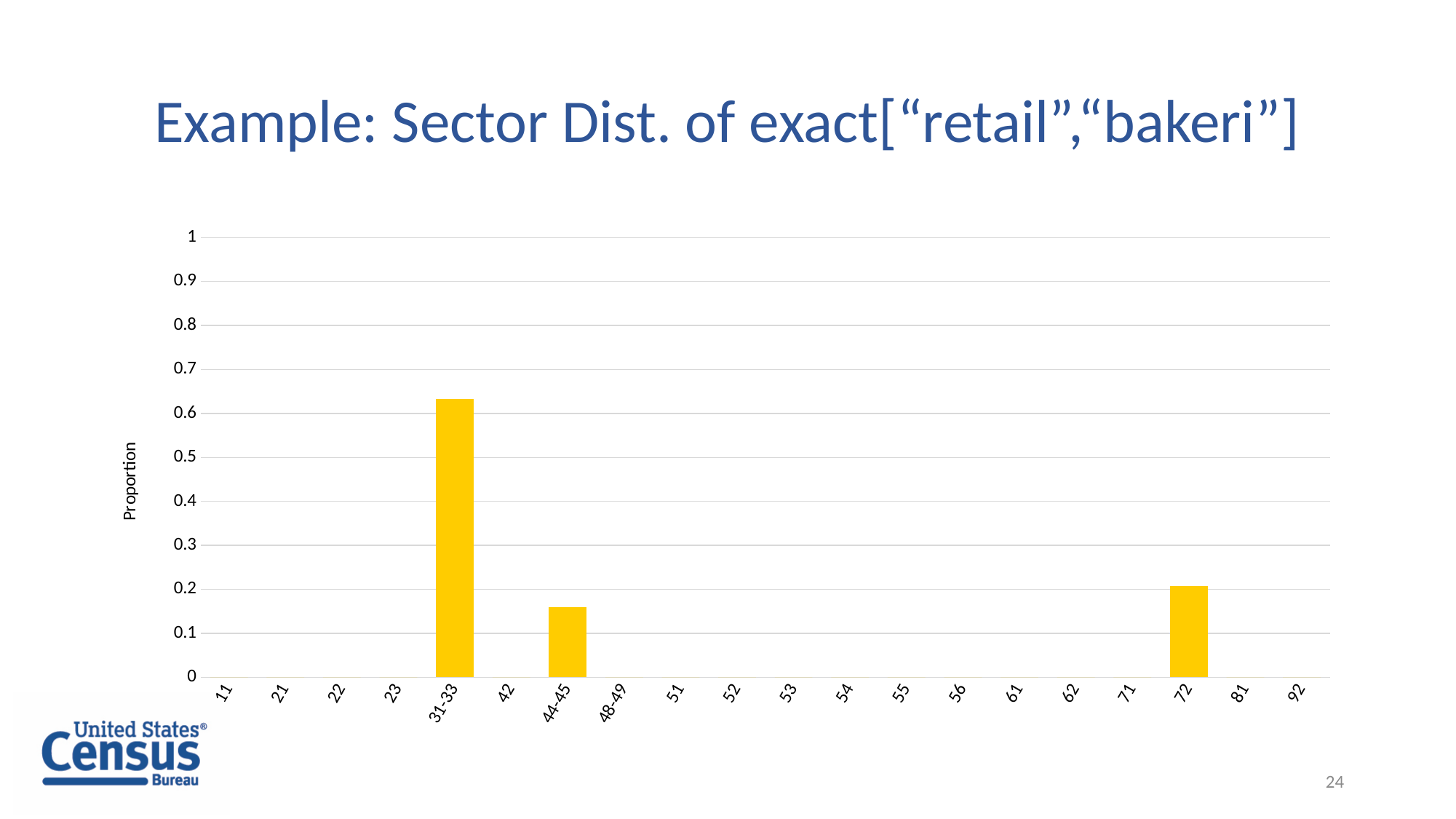
Which sector category has the highest proportion? 31-33 What kind of chart is shown on the slide? bar chart Is the proportion for sector 44-45 greater or less than 0.2? less What is the title of the slide? Example: Sector Dist. of exact["retail","bakeri"] Which has a larger proportion, sector 44-45 or sector 72? 72 Is the proportion for sector 31-33 greater or less than 0.5? greater Is the proportion for sector 72 greater or less than 0.1? greater How many sector categories have a visible non-zero bar? 3 Which has a larger proportion, sector 31-33 or sector 72? 31-33 What is the label on the y axis? Proportion How many sector categories are listed along the x axis? 20